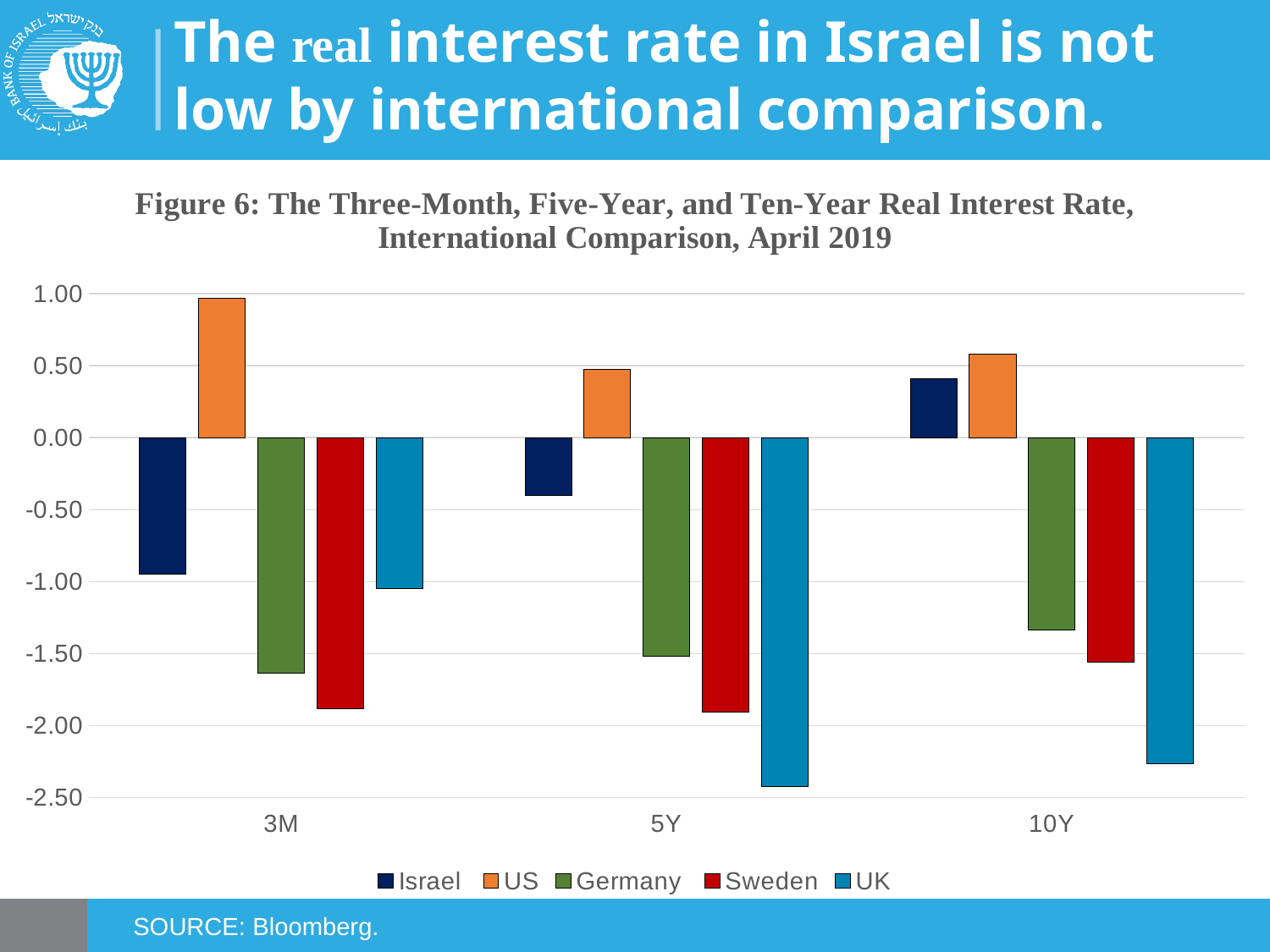
At 10Y, which is larger: the value for Israel or the value for UK? Israel Which country has the lowest real interest rate at 5Y? UK Is the value for Israel at 3M greater or less than -0.50? less Is the value for US at 3M greater or less than 0.50? greater What colour represents Sweden in the legend? Red How many maturity categories are shown on the x axis? 3 What kind of chart is shown on the slide? Bar chart Which country has the lowest real interest rate at 10Y? UK Does the value for Israel rise or fall moving from 3M to 5Y to 10Y? Rises How many series does the legend list? 5 Which country has the highest real interest rate at 3M? US Is the value for UK at 5Y greater or less than -2.00? less